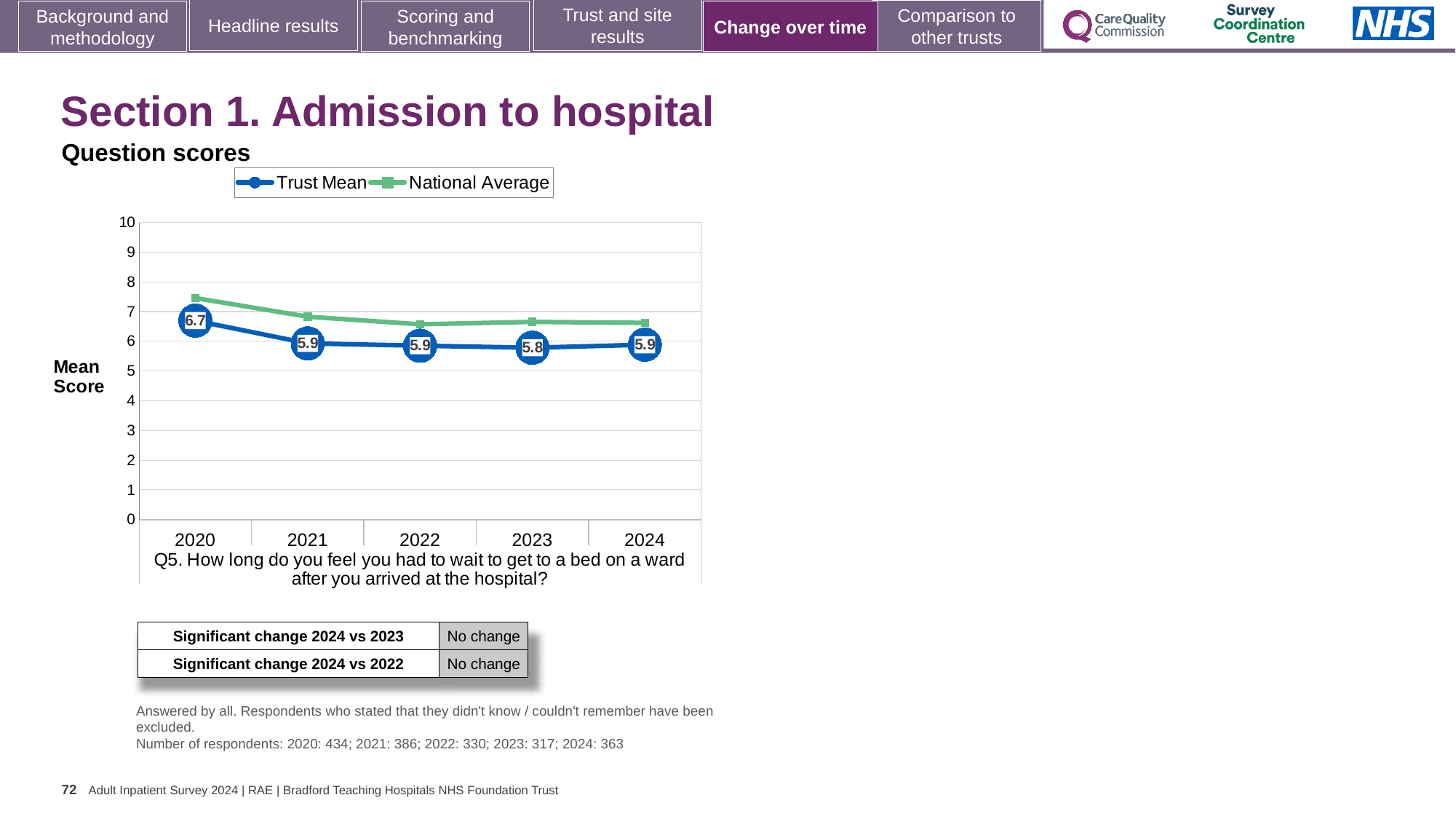
In which year is the Trust Mean score lowest? 2023 How many series does the legend list? 2 What is the Trust Mean score for 2020? 6.7 In which year is the Trust Mean score highest? 2020 Which is larger in 2020: the Trust Mean or the National Average? National Average How many years are shown on the x axis? 5 Is the National Average value for 2022 greater or less than 7? less What is the Trust Mean score for 2023? 5.8 What is the difference between the Trust Mean score in 2020 and in 2021? 0.8 What is the Trust Mean score for 2024? 5.9 Is the National Average value for 2020 greater or less than 7? greater What kind of chart is shown? Line chart